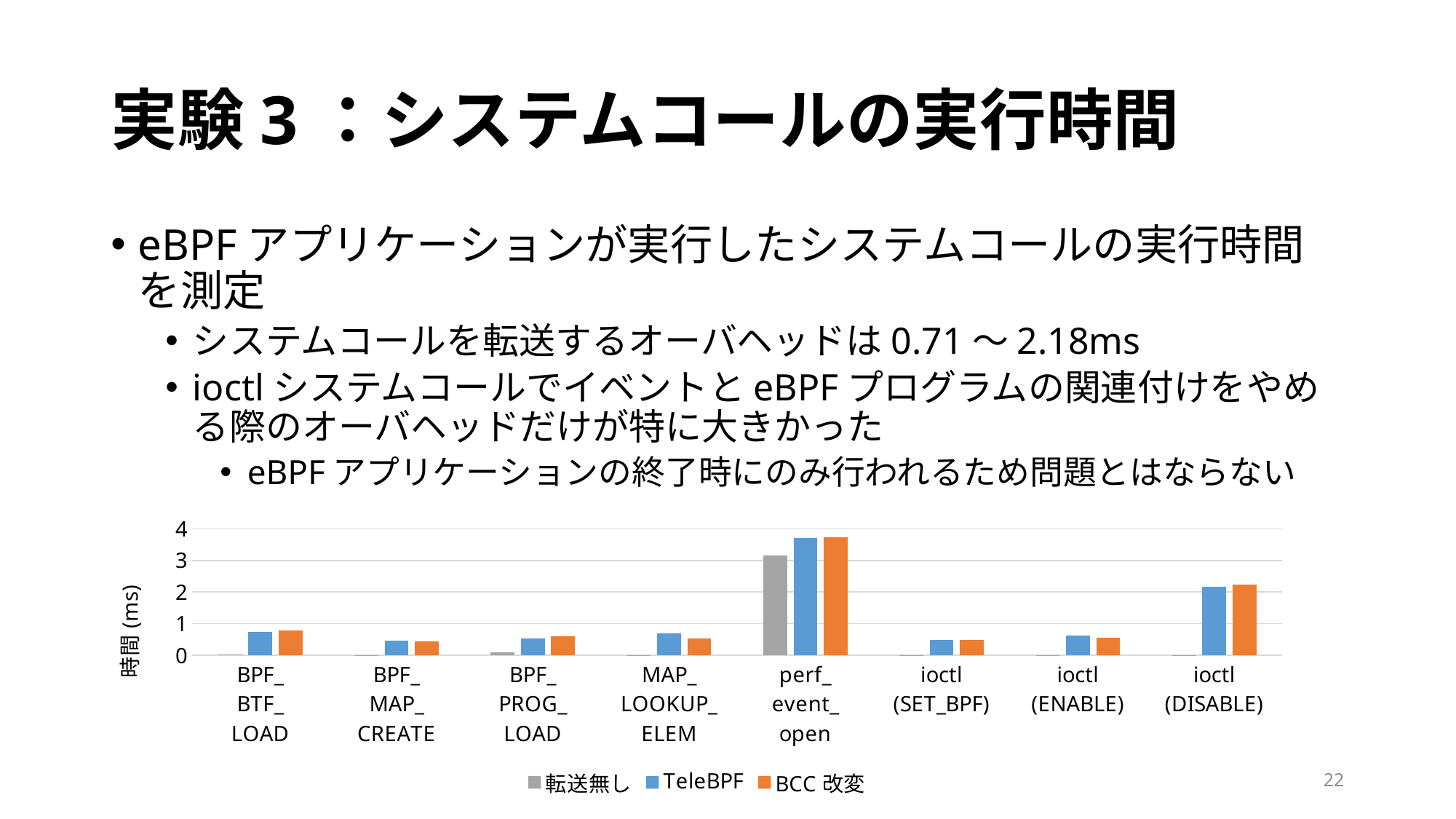
Which is larger, the BCC 改変 value for ioctl (DISABLE) or the BCC 改変 value for ioctl (ENABLE)? ioctl (DISABLE) Is the TeleBPF value for perf_event_open greater or less than 3? greater How many series does the chart's legend list? 3 What is the label of the vertical axis of the chart? 時間 (ms) Which category has the highest TeleBPF value in the chart? perf_event_open What kind of chart is shown on the slide? bar chart Is the TeleBPF value for BPF_BTF_LOAD greater or less than 1? less Is the 転送無し value for perf_event_open greater or less than 2? greater How many system call categories are shown on the x axis of the chart? 8 Which is larger, the TeleBPF value for perf_event_open or the TeleBPF value for ioctl (DISABLE)? perf_event_open What are the three series named in the chart's legend? 転送無し, TeleBPF, BCC 改変